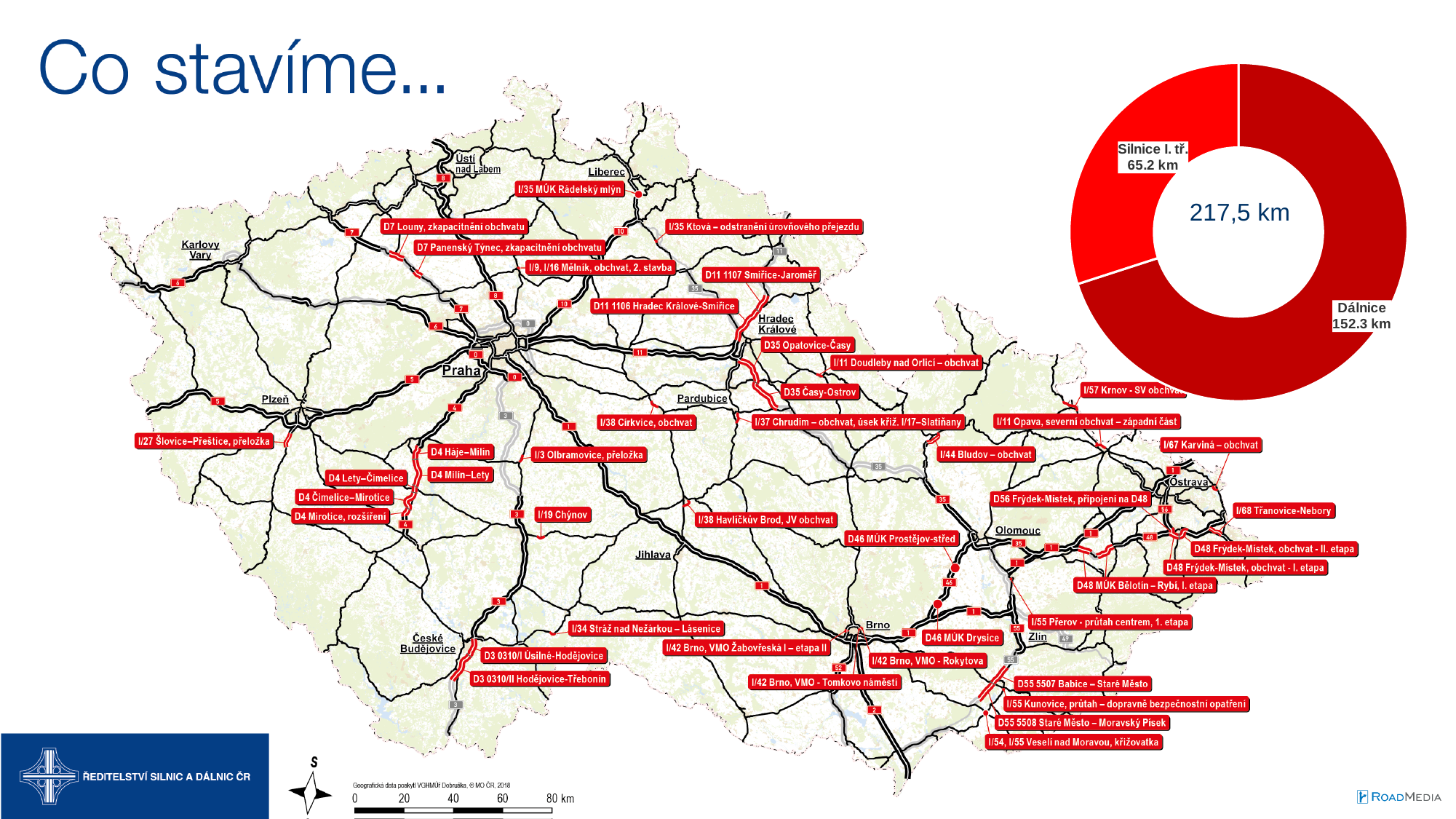
How many categories does the doughnut chart show? 2 Which category in the doughnut chart has the smallest value? Silnice I. tř. In the doughnut chart, which is larger: Dálnice or Silnice I. tř.? Dálnice What total value is shown in the centre of the doughnut chart? 217,5 km Which category in the doughnut chart has the largest value? Dálnice What is the difference between the Dálnice and Silnice I. tř. values in the doughnut chart? 87.1 km In the doughnut chart, what is the value for Dálnice? 152.3 km What is the title of the slide containing the doughnut chart? Co stavíme... In the doughnut chart, what is the value for Silnice I. tř.? 65.2 km What kind of chart is shown on the right side of the slide? doughnut chart